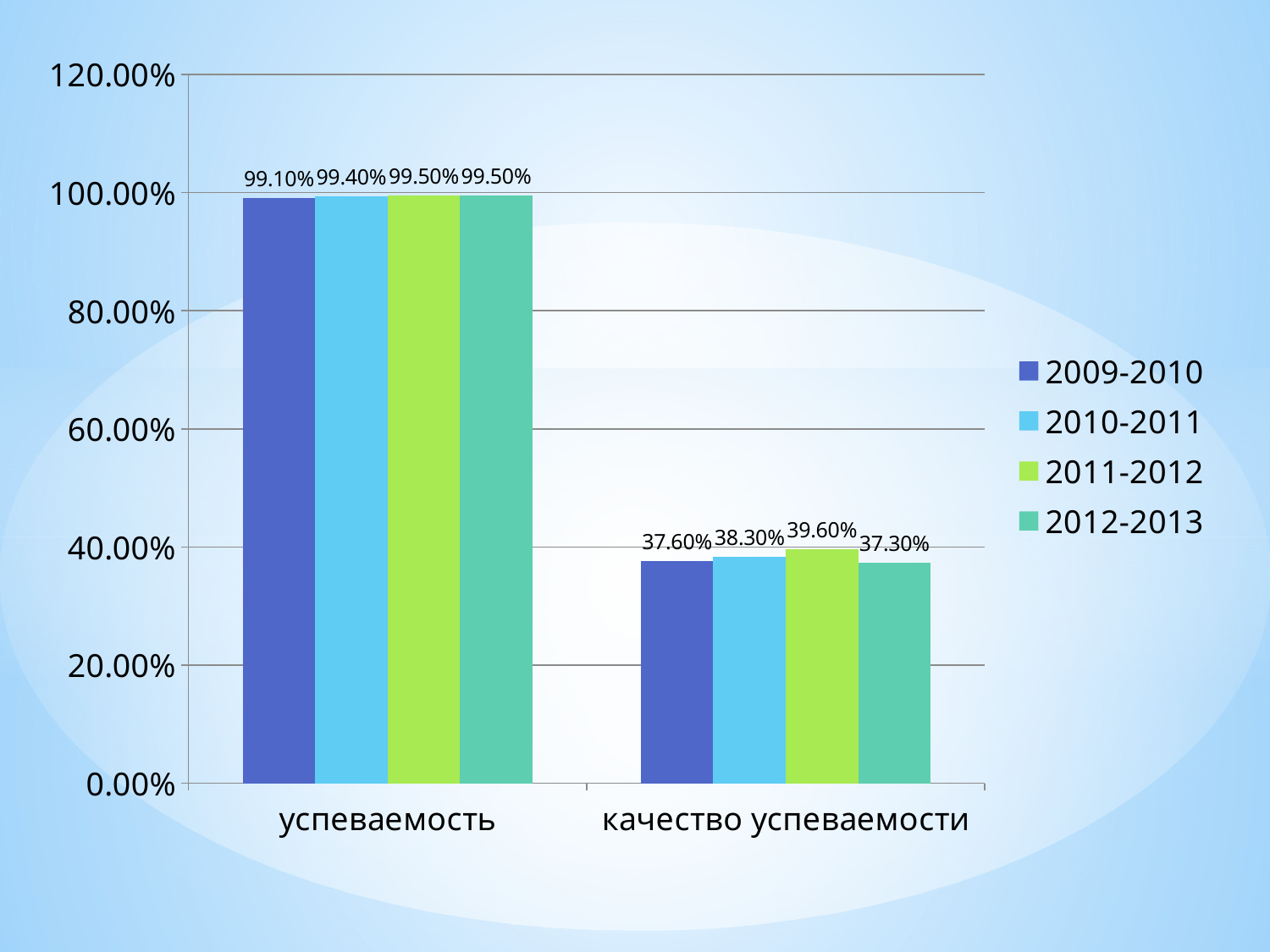
How many series does the legend list? 4 What kind of chart is shown on the slide? bar chart Which series has the highest value in the качество успеваемости category? 2011-2012 What is the difference between the 2009-2010 value for успеваемость and the 2009-2010 value for качество успеваемости? 61.50% Which is larger in the качество успеваемости category: the 2010-2011 value or the 2012-2013 value? 2010-2011 Which legend entry is shown in dark blue? 2009-2010 What is the value for 2012-2013 in the качество успеваемости category? 37.30% Which series has the lowest value in the успеваемость category? 2009-2010 How many categories are shown on the x axis? 2 What is the value for 2009-2010 in the успеваемость category? 99.10% What is the value for 2011-2012 in the качество успеваемости category? 39.60% What is the difference between the 2011-2012 and 2012-2013 values in the качество успеваемости category? 2.30%